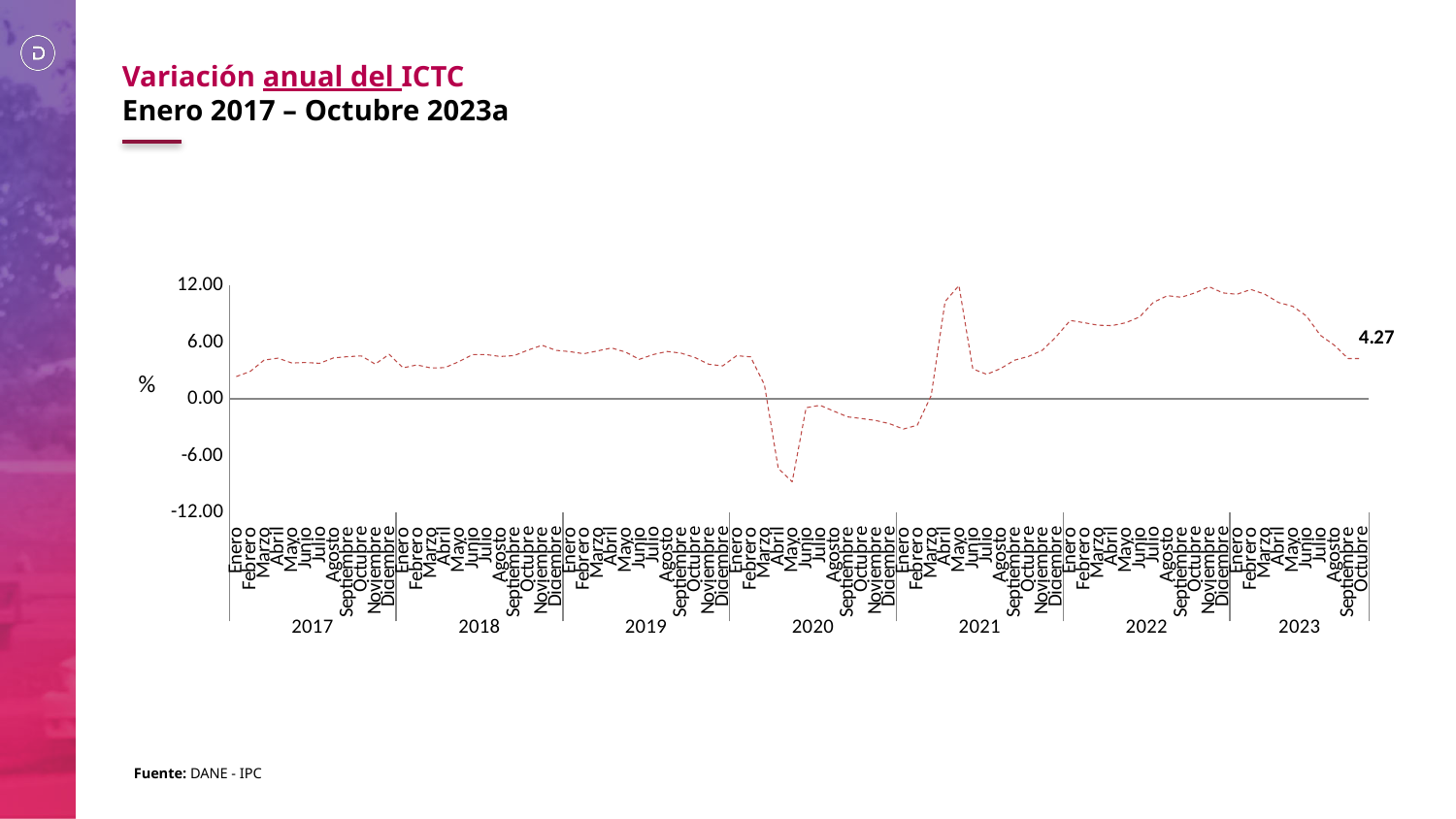
What source is cited for the chart? DANE - IPC From January 2023 to October 2023, does the line rise or fall? fall Is the value for January 2017 greater or less than 6.00? less What is the value of the annual variation of the ICTC for October 2023? 4.27 What type of chart is shown on the slide? line chart How many years are labelled along the x axis? 7 In which year does the line reach its lowest value? 2020 Is the value for December 2020 greater or less than 0.00? less Which is larger, the value for April 2021 or the value for October 2023? April 2021 Is the value for May 2020 greater or less than -6.00? less What is the title of the chart? Variación anual del ICTC, Enero 2017 – Octubre 2023a